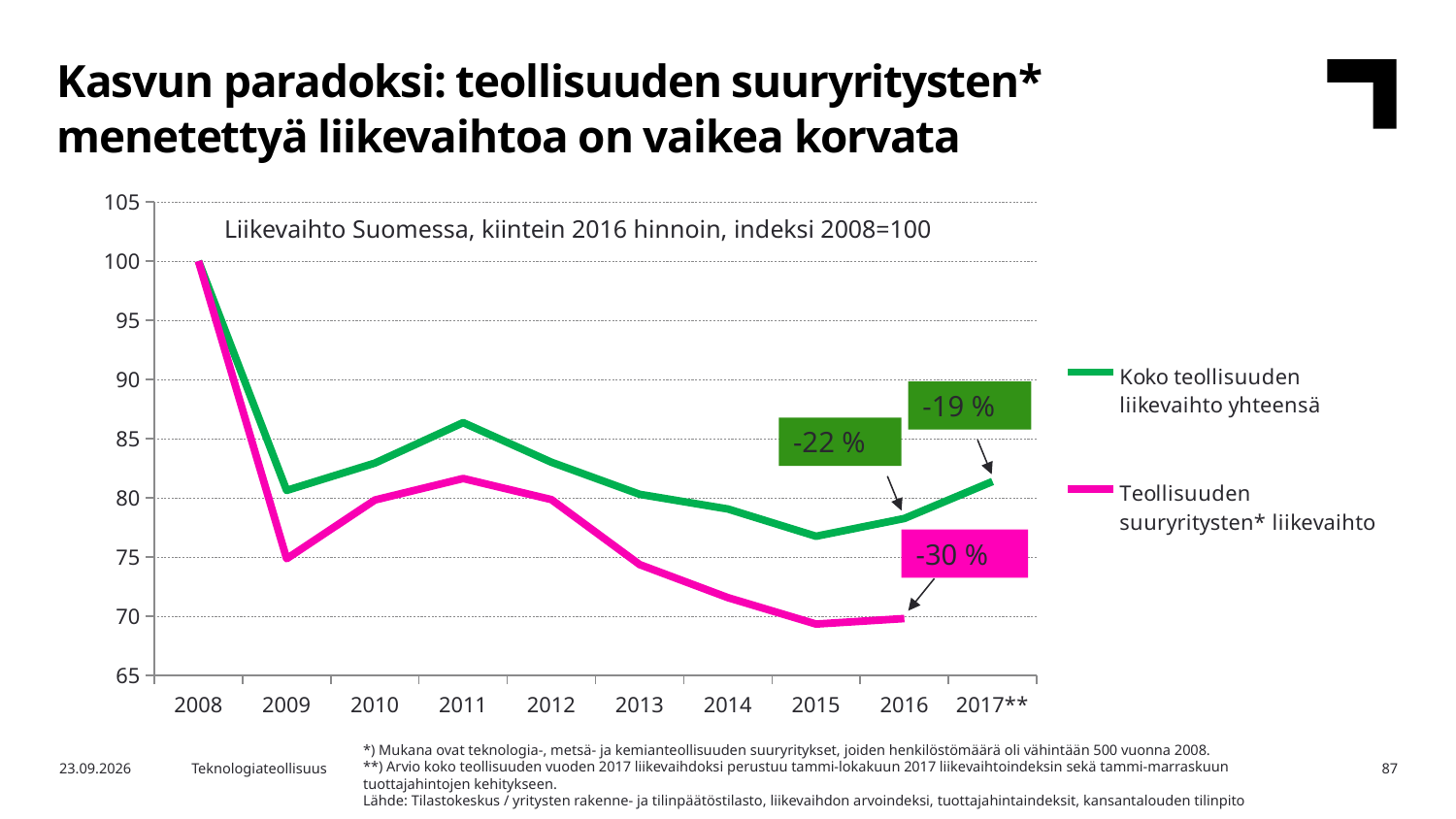
What percentage change is labelled on the Koko teollisuuden liikevaihto yhteensä line at 2017**? -19 % What is the title shown inside the chart area? Liikevaihto Suomessa, kiintein 2016 hinnoin, indeksi 2008=100 What percentage change is labelled on the Koko teollisuuden liikevaihto yhteensä line at 2016? -22 % Is the value for Teollisuuden suuryritysten* liikevaihto in 2015 greater or less than 75? less How many series does the legend list? 2 How many years are shown on the x axis? 10 What percentage change is labelled on the Teollisuuden suuryritysten* liikevaihto line at 2016? -30 % In 2011, which series has the higher value: Koko teollisuuden liikevaihto yhteensä or Teollisuuden suuryritysten* liikevaihto? Koko teollisuuden liikevaihto yhteensä Do the values of both series rise or fall from 2008 to 2009? fall What kind of chart is shown on the slide? line chart What is the index value of both series in 2008? 100 Is the value for Koko teollisuuden liikevaihto yhteensä in 2015 greater or less than 80? less